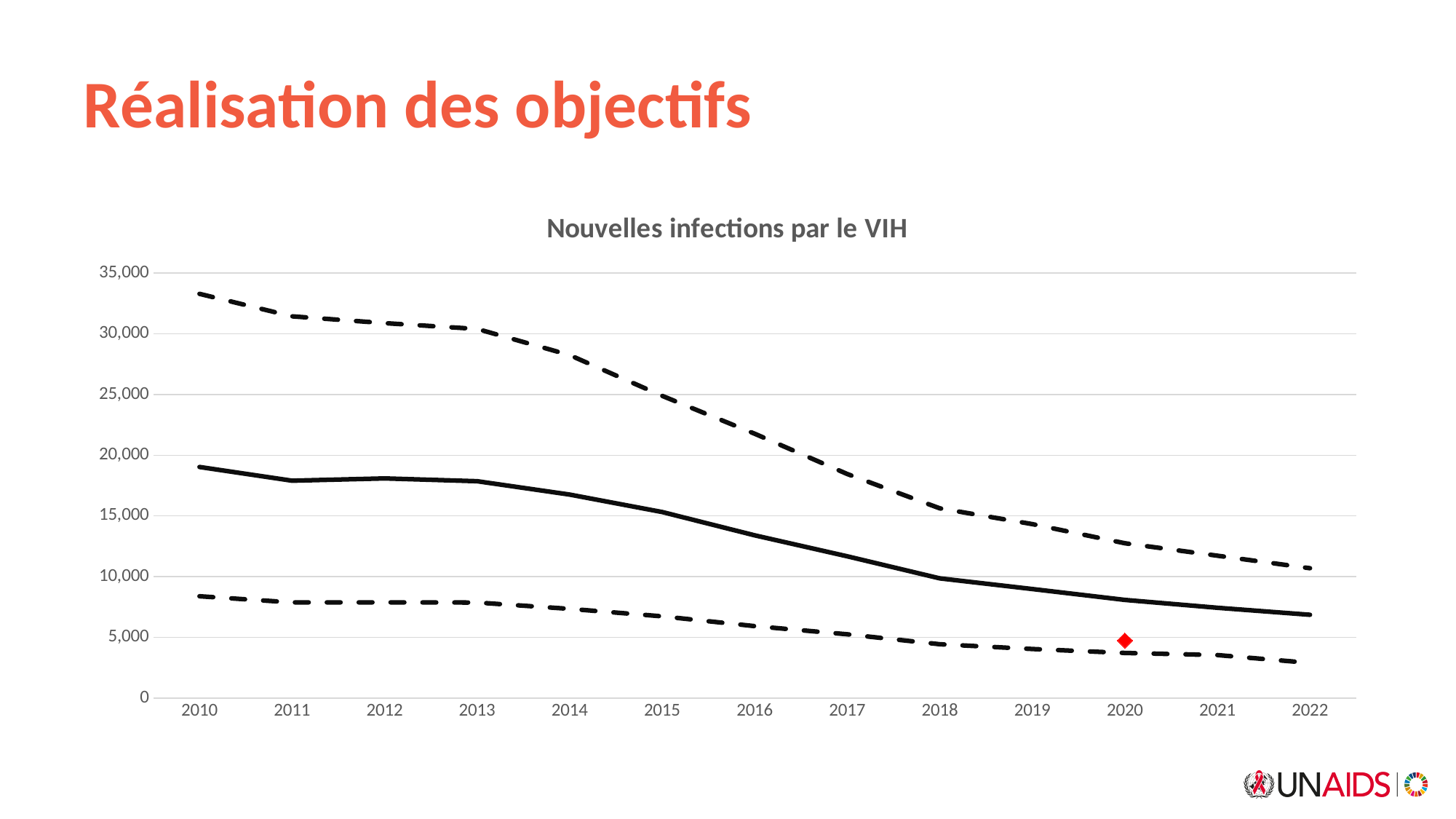
Is the value of the upper dashed line in 2017 greater or less than 20,000? less Is the value of the solid line in 2022 greater or less than 10,000? less What is the title of the chart? Nouvelles infections par le VIH Is the value of the lower dashed line in 2022 greater or less than 5,000? less In which year is the red diamond marker plotted on the chart? 2020 Does the solid line rise or fall from 2010 to 2022? fall What type of chart is shown on the slide? line chart How many years are shown on the x axis of the chart? 13 Does the upper dashed line rise or fall from 2010 to 2022? fall